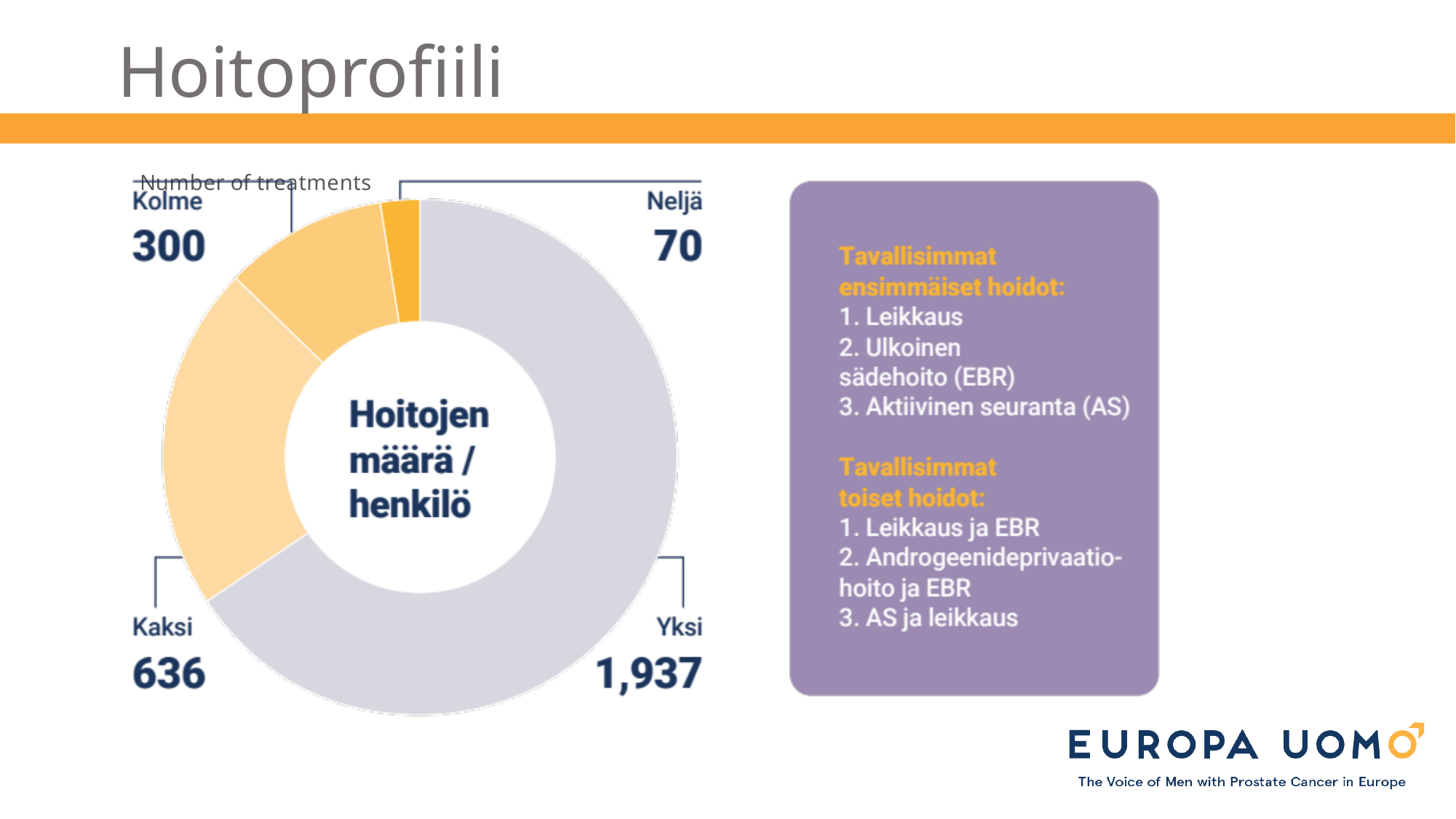
Which category has the highest value? Yksi What is the difference between the values for Yksi and Kaksi? 1,301 How many categories does the donut chart show? 4 What kind of chart is shown on the slide? Pie chart (donut) What is the difference between the values for Kolme and Neljä? 230 What is the value for Kaksi? 636 Which is larger, the value for Kaksi or the value for Kolme? Kaksi What is the value for Yksi? 1,937 What is the value for Neljä? 70 What text is written in the centre of the donut chart? Hoitojen määrä / henkilö What is the value for Kolme? 300 Which category has the lowest value? Neljä